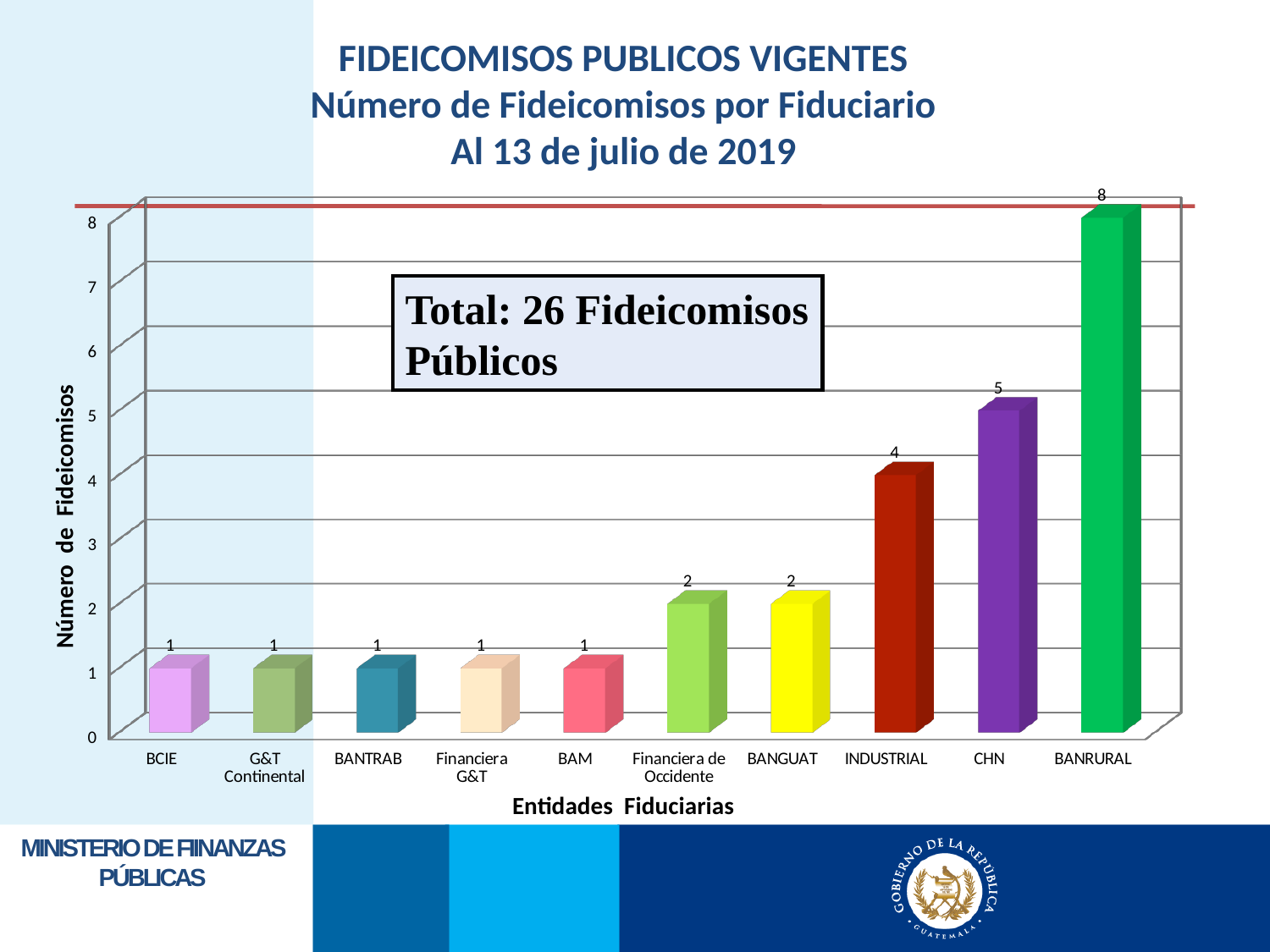
How many entities have a value of 1? 5 What is the value for BANGUAT? 2 Which entity has the highest number of fideicomisos? BANRURAL What kind of chart is shown on the slide? Bar chart Which is larger, the value for INDUSTRIAL or the value for Financiera de Occidente? INDUSTRIAL Do the values generally rise or fall from left to right along the x axis? Rise What total number of fideicomisos públicos is stated in the text box on the chart? 26 How many fideicomisos does BANRURAL have? 8 How many entities (categories) are shown on the x axis? 10 What is the value for INDUSTRIAL? 4 What is the value for CHN? 5 What is the difference between the values for BANRURAL and CHN? 3